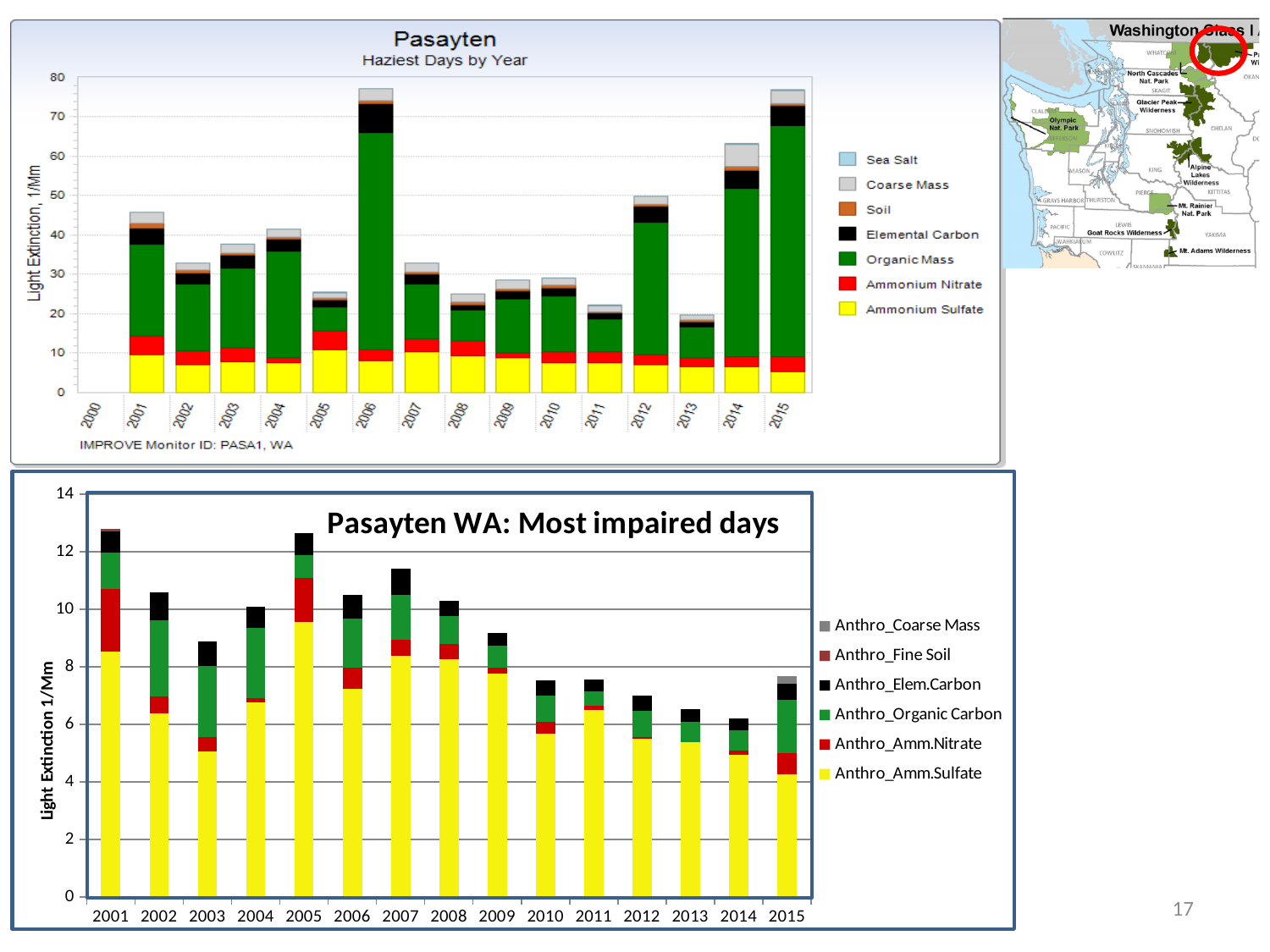
In the 'Pasayten WA: Most impaired days' chart, is the total for 2003 greater or less than 10? less In the 'Pasayten WA: Most impaired days' chart, do the totals rise or fall from 2009 to 2014? fall In the 'Pasayten WA: Most impaired days' chart, which year has the larger total, 2007 or 2008? 2007 What type of chart is the 'Pasayten WA: Most impaired days' chart? stacked bar chart In the 'Pasayten Haziest Days by Year' chart, is the total for 2006 greater or less than 70? greater How many years are shown on the x axis of the 'Pasayten WA: Most impaired days' chart? 15 In the 'Pasayten WA: Most impaired days' chart, which year has the lowest total light extinction? 2014 How many series does the legend of the 'Pasayten WA: Most impaired days' chart list? 6 In the 'Pasayten Haziest Days by Year' chart, which year has the lowest total light extinction? 2013 In the 'Pasayten Haziest Days by Year' chart, which colour represents Organic Mass? green How many series does the legend of the 'Pasayten Haziest Days by Year' chart list? 7